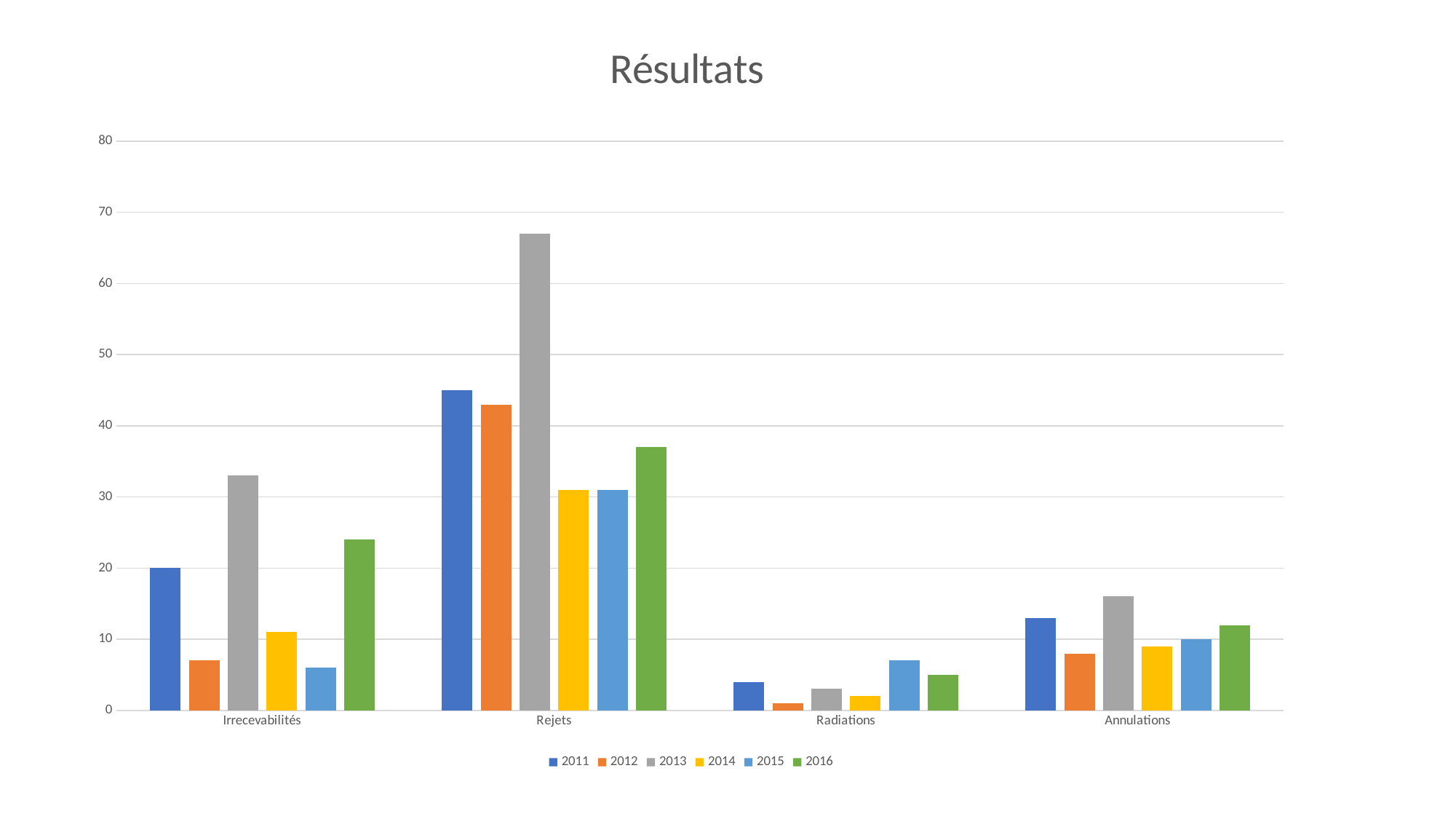
How many categories are shown on the x axis? 4 How many series does the legend list? 6 Is the value for 2013 in the Rejets category greater or less than 60? greater What is the value for 2011 in the Irrecevabilités category? 20 Is the value for 2013 in the Annulations category greater or less than 20? less What is the title of the chart? Résultats What kind of chart is shown on the slide? bar chart Within the Rejets category, which year has the tallest bar? 2013 In the Irrecevabilités category, which is larger: the 2013 value or the 2016 value? 2013 Which category has the lowest value for the 2012 series? Radiations Which category has the highest value for the 2013 series? Rejets Is the value for 2015 in the Irrecevabilités category greater or less than 10? less